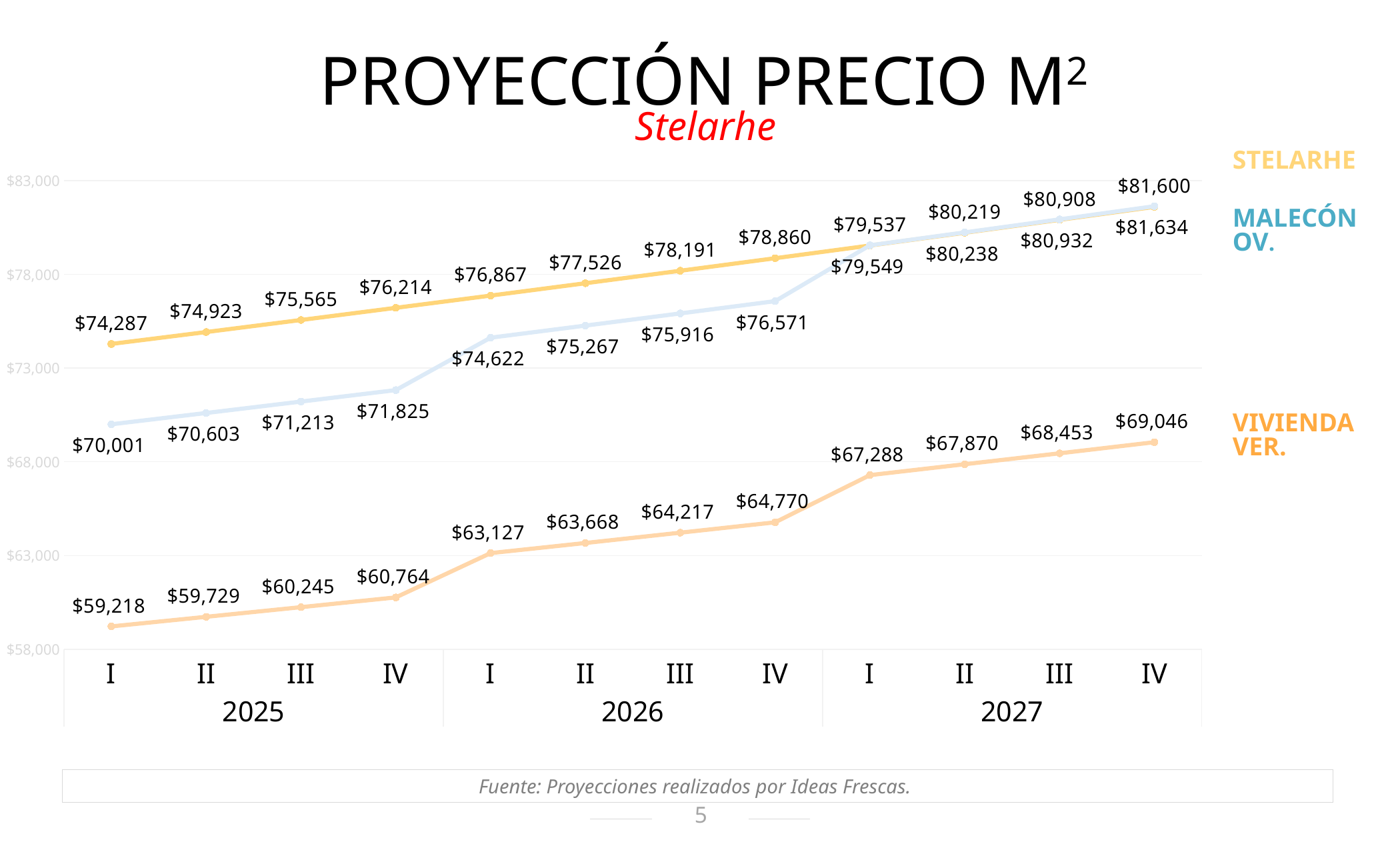
What is the projected price per m² for VIVIENDA VER. in quarter IV of 2027? $69,046 In which quarter is the STELARHE projected price lowest? I 2025 Is the MALECÓN OV. value in quarter I of 2025 greater or less than $73,000? less What is the projected price per m² for MALECÓN OV. in quarter I of 2026? $74,622 In quarter IV of 2025, which series has the higher projected price, STELARHE or MALECÓN OV.? STELARHE What is the projected price per m² for STELARHE in quarter I of 2025? $74,287 How many series does the chart show? 3 What type of chart is shown on the slide? line chart How many quarters are plotted along the x axis? 12 In which quarter does VIVIENDA VER. reach its highest projected price? IV 2027 By how much does the STELARHE price in quarter IV of 2027 exceed its price in quarter I of 2025? $7,313 What is the difference between the MALECÓN OV. price in quarter I of 2026 and quarter IV of 2025? $2,797